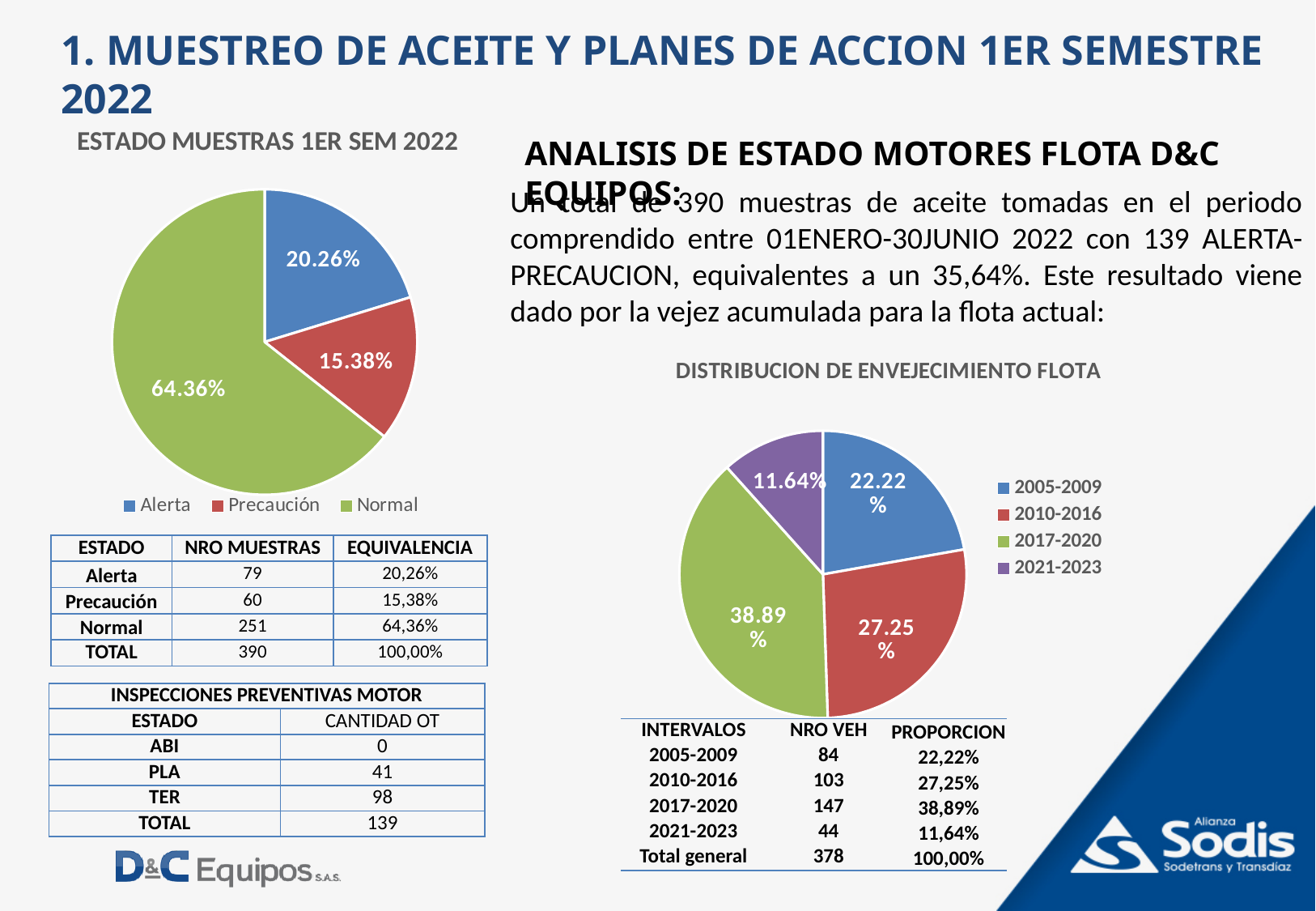
How many categories does the legend of the 'ESTADO MUESTRAS 1ER SEM 2022' chart list? 3 In the 'DISTRIBUCION DE ENVEJECIMIENTO FLOTA' chart, what colour is the 2021-2023 slice? Purple How many intervals does the legend of the 'DISTRIBUCION DE ENVEJECIMIENTO FLOTA' chart list? 4 In the 'DISTRIBUCION DE ENVEJECIMIENTO FLOTA' chart, which is larger: 2005-2009 or 2010-2016? 2010-2016 In the 'DISTRIBUCION DE ENVEJECIMIENTO FLOTA' chart, what percentage is shown for 2021-2023? 11.64% In the 'ESTADO MUESTRAS 1ER SEM 2022' chart, which category has the smallest slice? Precaución In the 'DISTRIBUCION DE ENVEJECIMIENTO FLOTA' chart, which interval has the largest share? 2017-2020 In the 'DISTRIBUCION DE ENVEJECIMIENTO FLOTA' chart, what percentage is shown for 2017-2020? 38.89% What kind of chart is 'ESTADO MUESTRAS 1ER SEM 2022'? Pie chart In the 'ESTADO MUESTRAS 1ER SEM 2022' chart, what percentage is shown for Normal? 64.36% In the 'ESTADO MUESTRAS 1ER SEM 2022' chart, what is the difference in percentage points between Alerta and Precaución? 4.88 In the 'ESTADO MUESTRAS 1ER SEM 2022' chart, what percentage is shown for Precaución? 15.38%